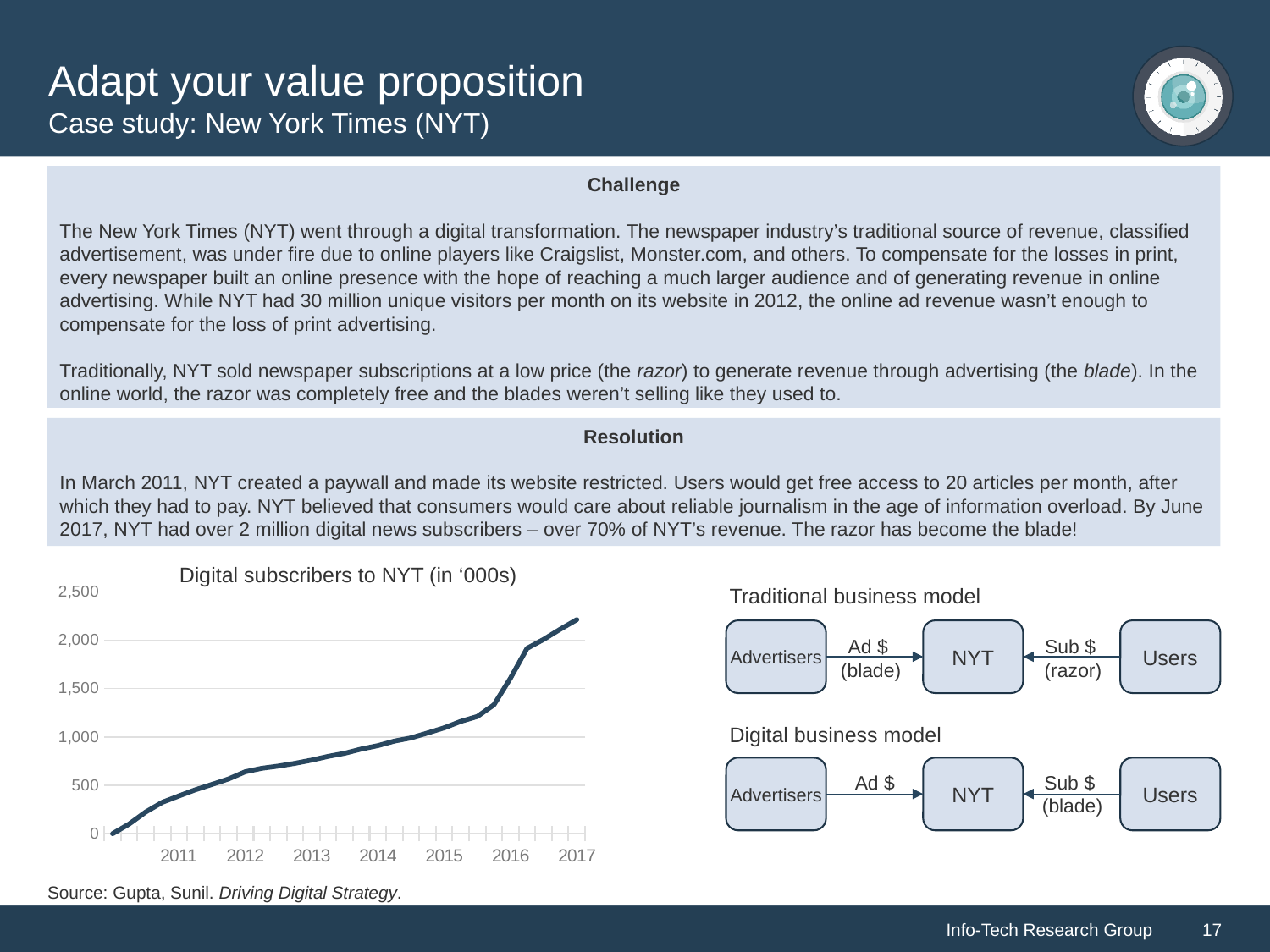
What kind of chart is shown on the slide? line chart Is the value for 2012 greater or less than 500? greater Is the value for 2015 greater or less than 1,000? greater Which year shows the highest number of digital subscribers in the chart? 2017 How many year labels are shown on the x axis of the chart? 7 Which is larger in the chart, the value for 2014 or the value for 2016? 2016 Is the value for 2017 greater or less than 2,000? greater Do the values in the chart rise or fall from 2011 to 2017? rise What is the title of the chart on the slide? Digital subscribers to NYT (in '000s)